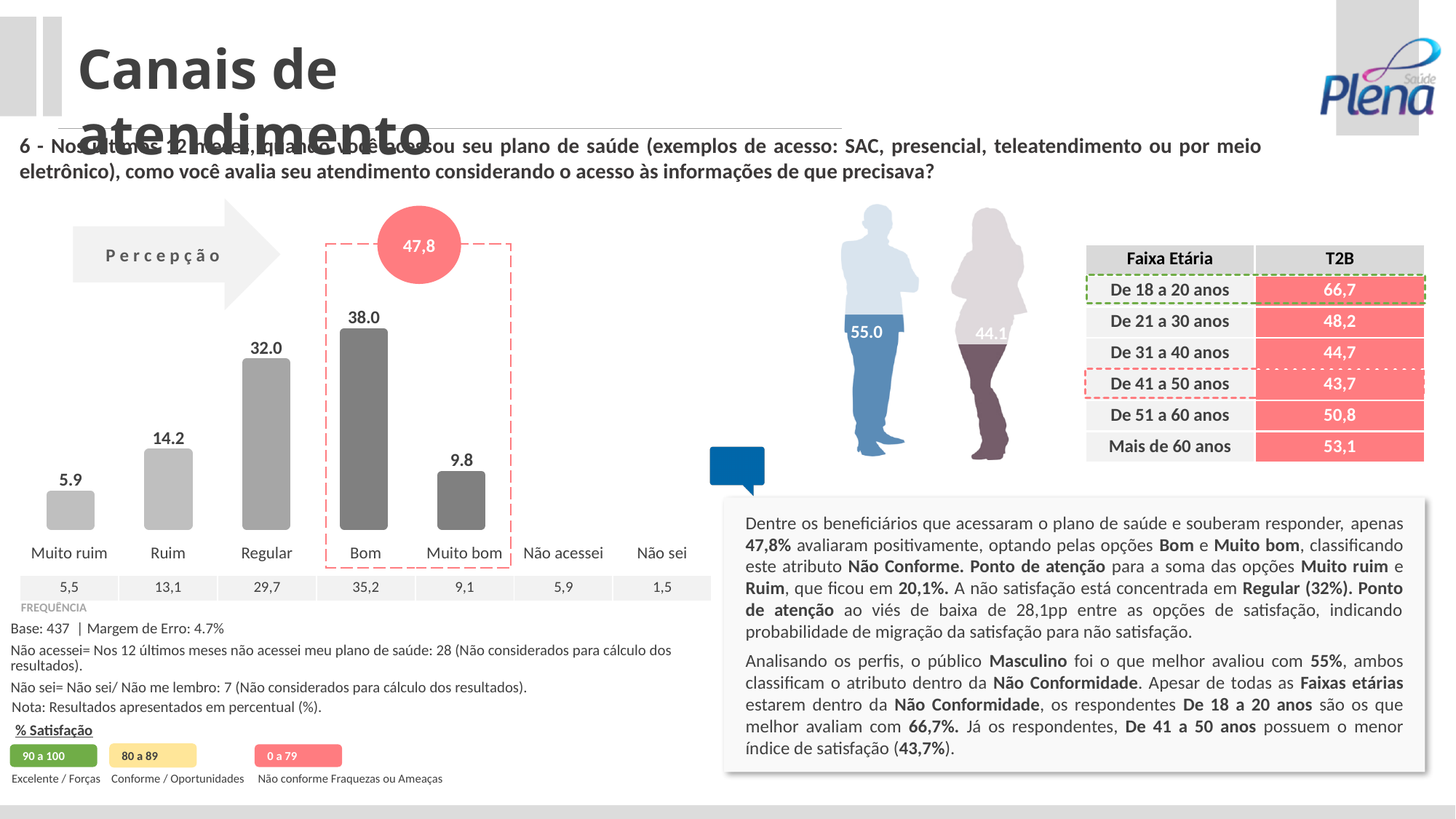
Which category has the highest bar in the bar chart? Bom What type of chart is shown on the left of the slide? bar chart Which category has the lowest bar in the bar chart? Muito ruim What is the value of the bar for Regular in the bar chart? 32.0 What is the difference between the values for Ruim and Muito ruim in the bar chart? 8.3 Which is larger in the bar chart, the value for Ruim or the value for Muito bom? Ruim What value is shown in the red circle above the Bom and Muito bom bars? 47,8 In the Faixa Etária table, what is the T2B value for De 41 a 50 anos? 43,7 What is the value of the bar for Muito ruim in the bar chart? 5.9 What is the value of the bar for Muito bom in the bar chart? 9.8 What is the difference between the values for Bom and Regular in the bar chart? 6.0 How many bars are plotted in the bar chart? 5